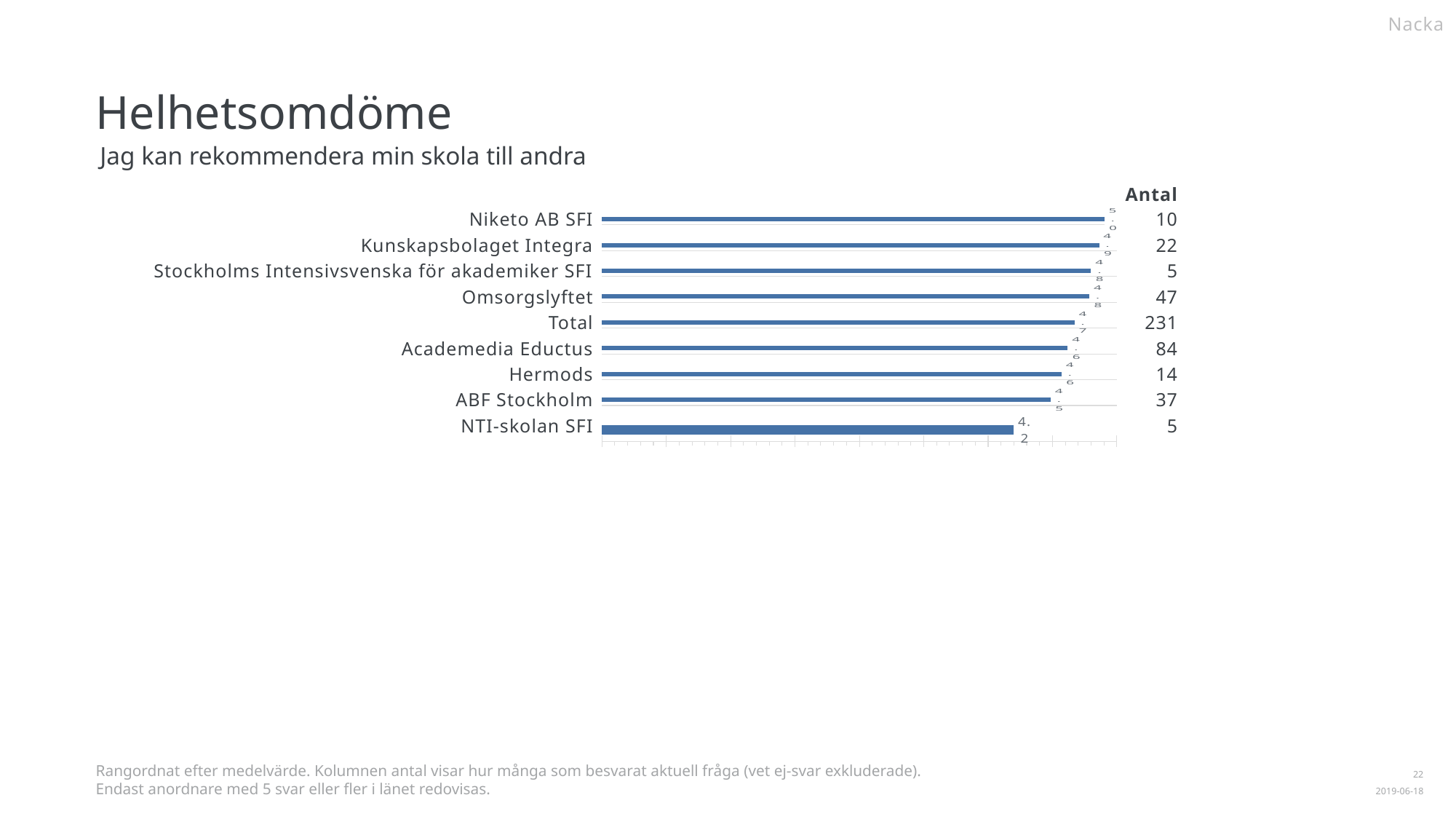
Which category has the highest value in the chart? Niketo AB SFI What is the Antal (count) shown for Academedia Eductus? 84 What is the difference between the value for Niketo AB SFI and the value for NTI-skolan SFI? 0.8 What is the Antal (count) shown for Total? 231 What is the heading of the numeric column to the right of the bars? Antal How many categories (bars) does the chart show? 9 Do the bar values rise or fall going from the top of the chart to the bottom? fall Which has the larger value, Omsorgslyftet or ABF Stockholm? Omsorgslyftet What is the value shown for Niketo AB SFI? 5.0 What kind of chart is shown on the slide? bar chart What is the value shown for NTI-skolan SFI? 4.2 Which category has the lowest value in the chart? NTI-skolan SFI